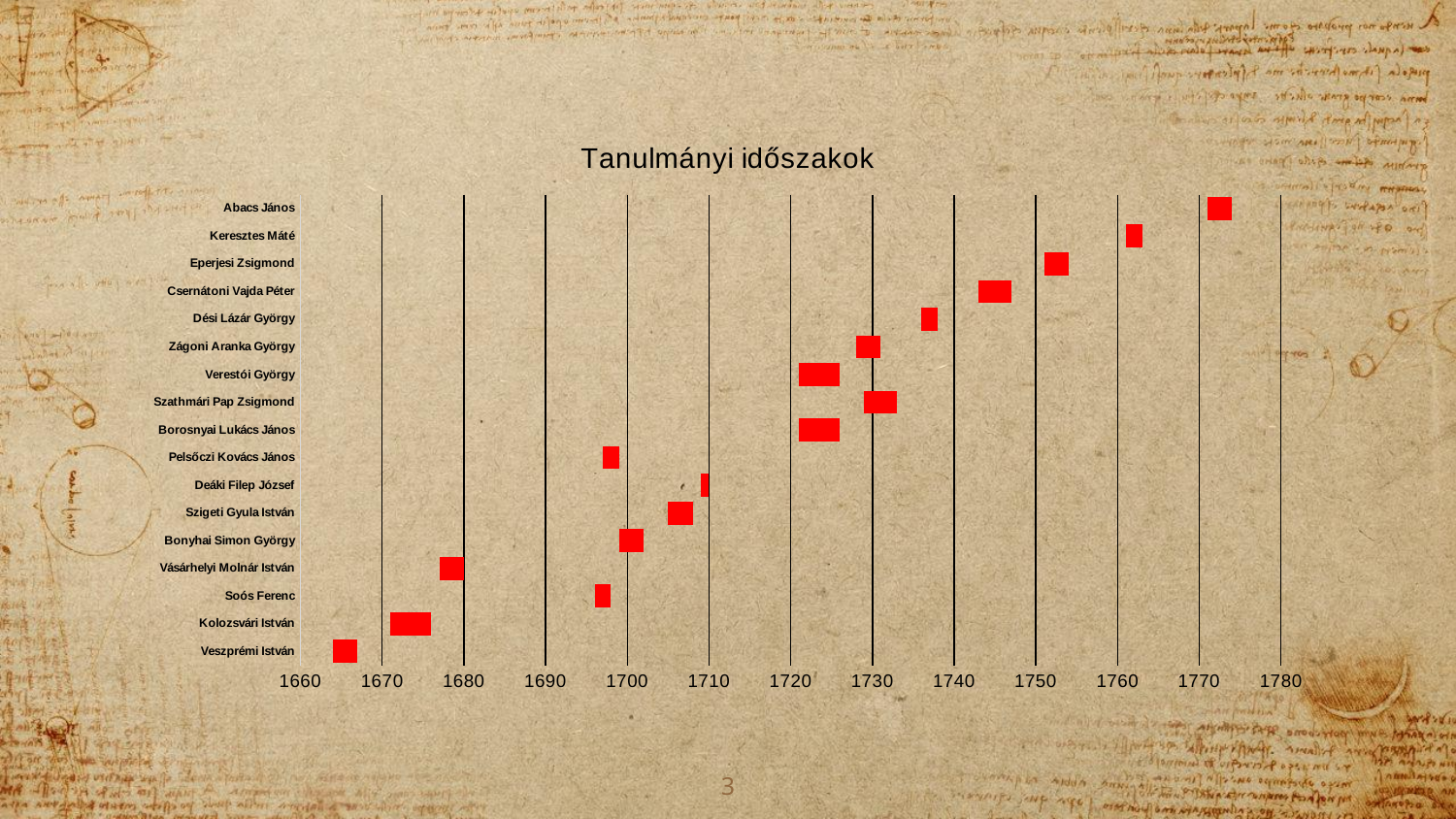
What is the title of the chart? Tanulmányi időszakok Is the study period of Veszprémi István greater or less than 1670? less Which person has the latest study period on the chart? Abacs János Moving from the bottom of the list (Veszprémi István) to the top (Abacs János), do the study periods get later or earlier? later What is the range of years shown on the horizontal axis? 1660 to 1780 Is the study period of Soós Ferenc greater or less than 1700? less Which person has the earliest study period on the chart? Veszprémi István Is the study period of Csernátoni Vajda Péter greater or less than 1740? greater How many people (categories) are listed on the chart? 17 Whose study period is later, Dési Lázár György or Soós Ferenc? Dési Lázár György What kind of chart is shown on the slide? bar chart